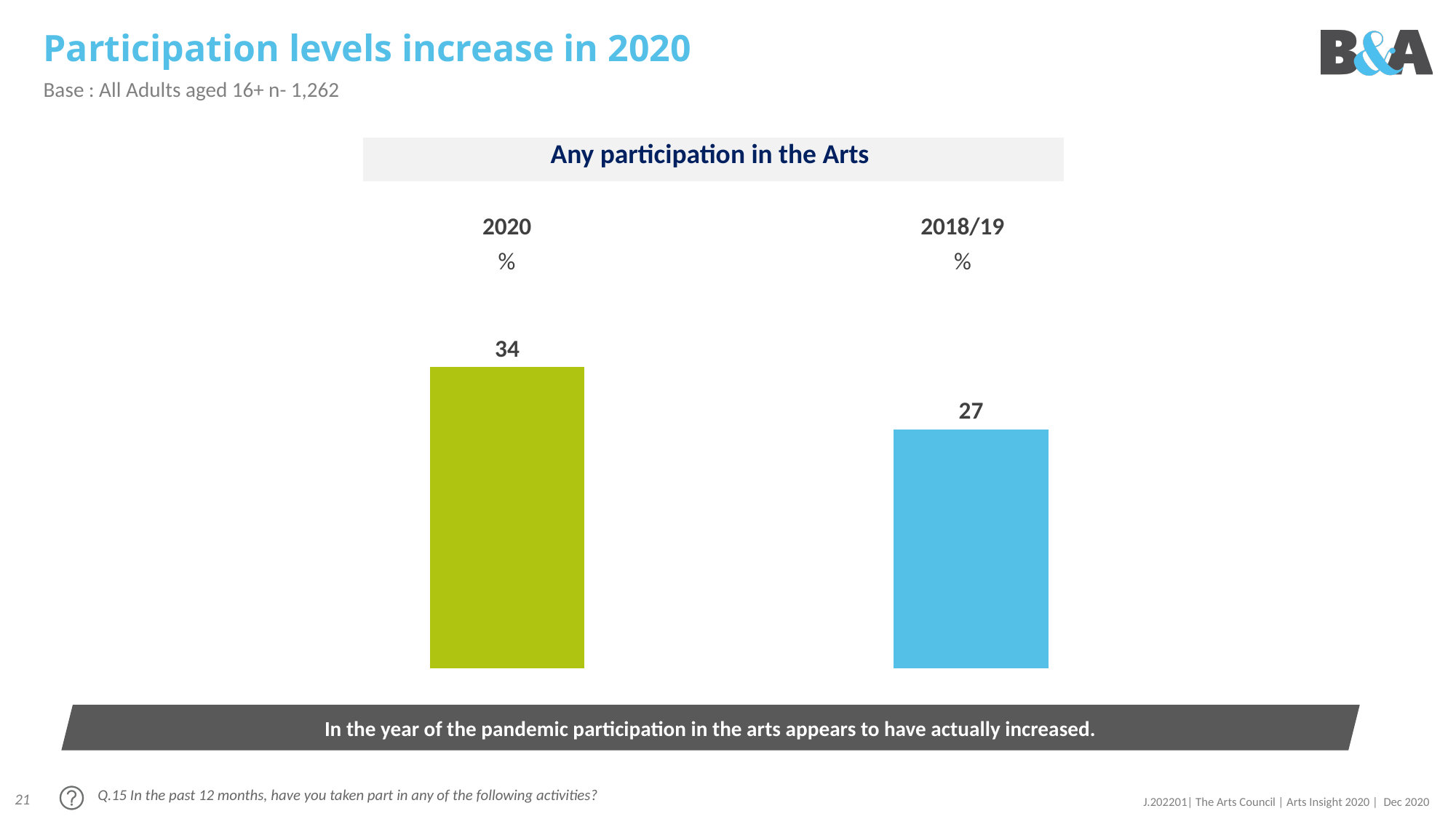
Which year has the lower participation value in the chart? 2018/19 What is the value for 2018/19 in the 'Any participation in the Arts' chart? 27 What is the value for 2020 in the 'Any participation in the Arts' chart? 34 What is the title shown above the chart? Any participation in the Arts What is the difference between the 2020 value and the 2018/19 value? 7 What colour is the bar for 2020? green Which year has the higher participation value, 2020 or 2018/19? 2020 What unit are the chart values expressed in? % Is the value for 2020 larger or smaller than the value for 2018/19? larger How many bars are shown in the chart? 2 What kind of chart is shown on the slide? bar chart